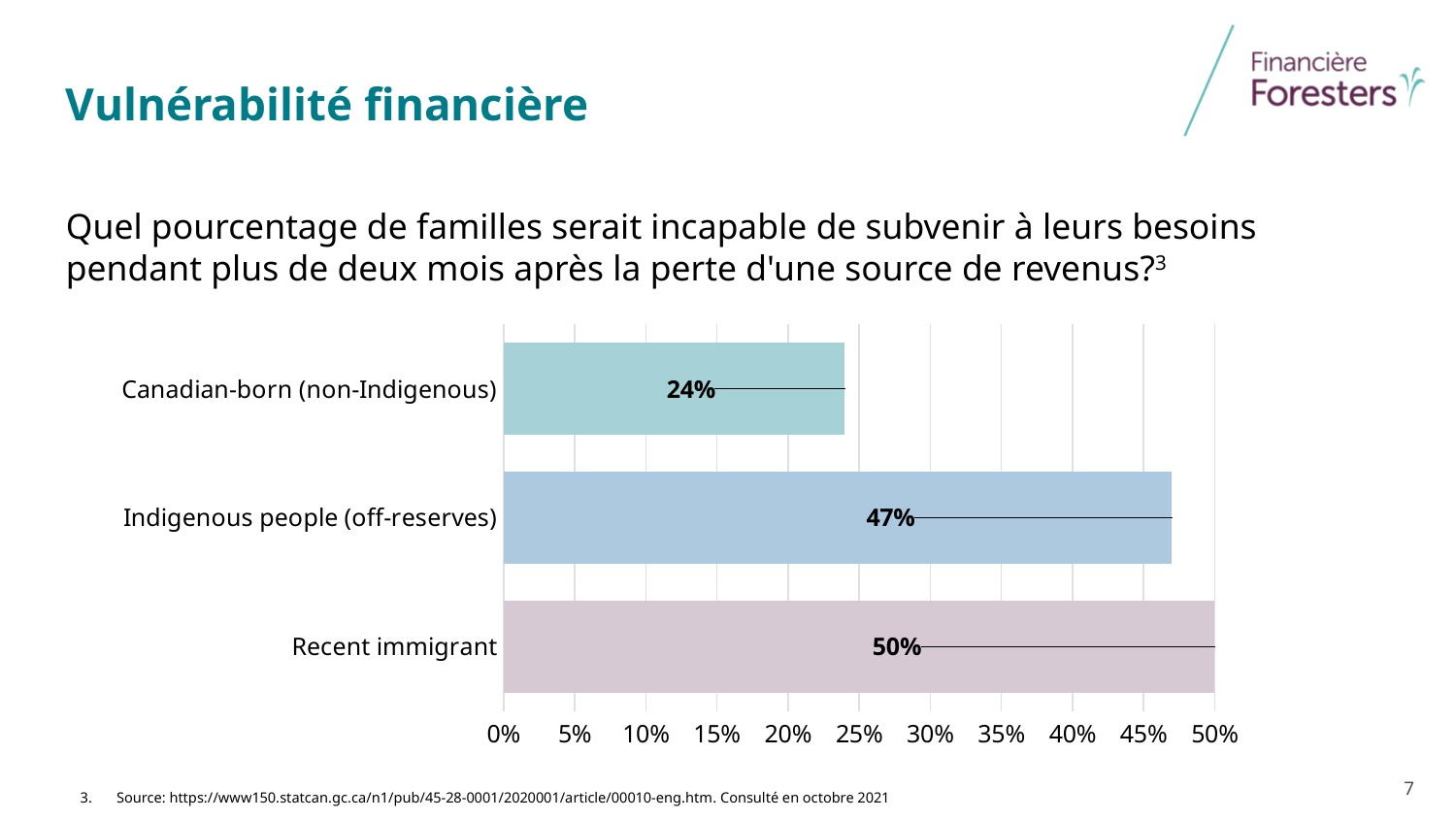
Which category has the highest value? Recent immigrant What is the value for Recent immigrant? 50% Which is larger, the value for Indigenous people (off-reserves) or the value for Canadian-born (non-Indigenous)? Indigenous people (off-reserves) What is the difference between the values for Recent immigrant and Canadian-born (non-Indigenous)? 26% What is the value for Canadian-born (non-Indigenous)? 24% What is the value for Indigenous people (off-reserves)? 47% Is the value for Canadian-born (non-Indigenous) greater or less than 30%? less How many categories are shown in the chart? 3 What kind of chart is shown on the slide? Bar chart Which category has the lowest value? Canadian-born (non-Indigenous) What is the highest value shown on the x axis? 50% What is the difference between the values for Indigenous people (off-reserves) and Canadian-born (non-Indigenous)? 23%